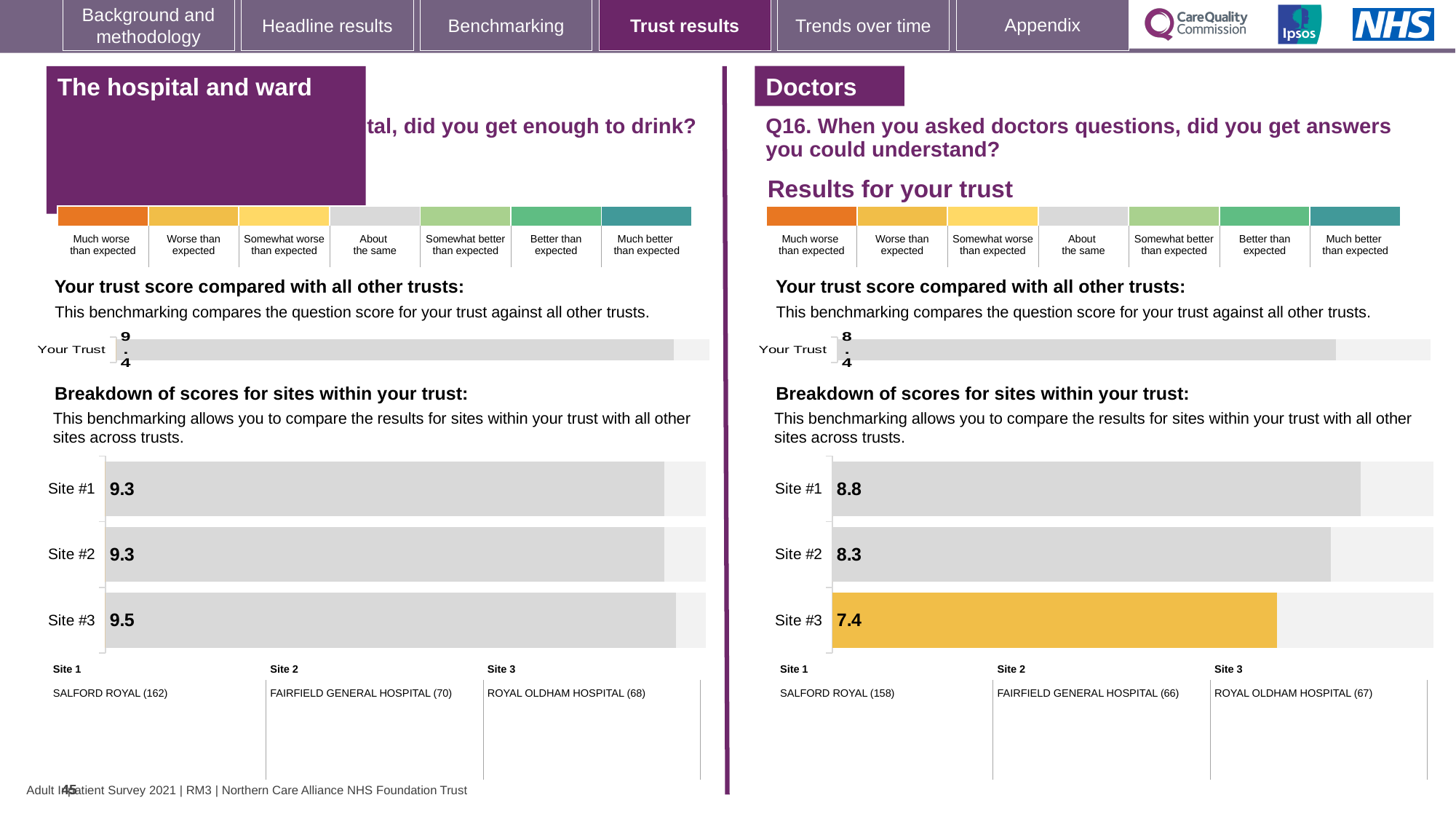
In the left-hand chart (The hospital and ward) breakdown of scores for sites, which site has the highest score? Site #3 How many sites are shown in the right-hand chart (Q16, Doctors) breakdown of scores for sites? 3 In the right-hand chart (Q16, Doctors) breakdown of scores for sites, which site has the highest score? Site #1 In the right-hand (Q16, Doctors) 'Your trust score compared with all other trusts' chart, what is the score for Your Trust? 8.4 In the right-hand chart (Q16, Doctors) breakdown of scores for sites, which site has the lowest score? Site #3 In the right-hand chart (Q16, Doctors) breakdown of scores for sites, what is the difference between the scores for Site #1 and Site #3? 1.4 What type of chart is used for the breakdown of scores for sites within your trust on the right-hand side (Q16, Doctors)? Bar chart In the left-hand chart (The hospital and ward) breakdown of scores for sites, what is the score for Site #3? 9.5 In the left-hand chart (The hospital and ward) breakdown of scores for sites, what is the difference between the scores for Site #3 and Site #1? 0.2 In the right-hand chart (Q16, Doctors) breakdown of scores for sites, which has the larger score, Site #2 or Site #3? Site #2 In the right-hand chart (Q16, Doctors) breakdown of scores for sites, what is the score for Site #3? 7.4 In the left-hand 'Your trust score compared with all other trusts' chart, what is the score for Your Trust? 9.4